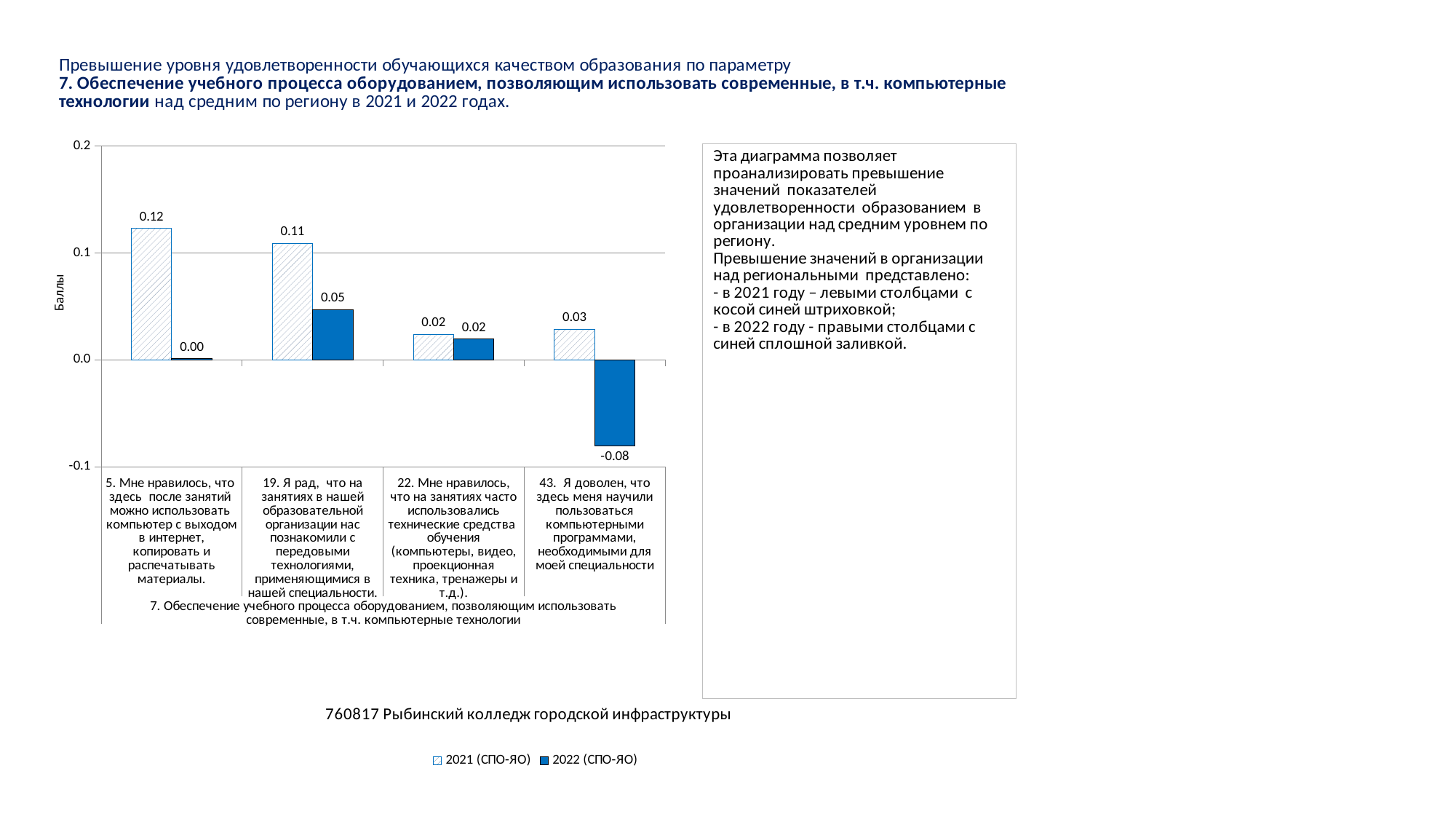
Which item has the highest value for the 2021 (СПО-ЯО) series? 5. Мне нравилось, что здесь после занятий можно использовать компьютер с выходом в интернет, копировать и распечатывать материалы. How many series does the chart legend list? 2 How many items (categories) are shown on the x axis of the chart? 4 Which item has the lowest value for the 2022 (СПО-ЯО) series? 43. Я доволен, что здесь меня научили пользоваться компьютерными программами, необходимыми для моей специальности What is the difference between the 2021 and 2022 values for item 19? 0.06 What is the value for 2022 (СПО-ЯО) for item 19 ("Я рад, что на занятиях в нашей образовательной организации нас познакомили с передовыми технологиями...")? 0.05 What is the label of the vertical axis of the chart? Баллы What is the difference between the 2021 and 2022 values for item 43? 0.11 What is the value for 2022 (СПО-ЯО) for item 43 ("Я доволен, что здесь меня научили пользоваться компьютерными программами...")? -0.08 What type of chart is shown on the slide? Bar chart What is the value for 2021 (СПО-ЯО) for item 5 ("Мне нравилось, что здесь после занятий можно использовать компьютер...")? 0.12 For item 5, which series has the larger value, 2021 (СПО-ЯО) or 2022 (СПО-ЯО)? 2021 (СПО-ЯО)